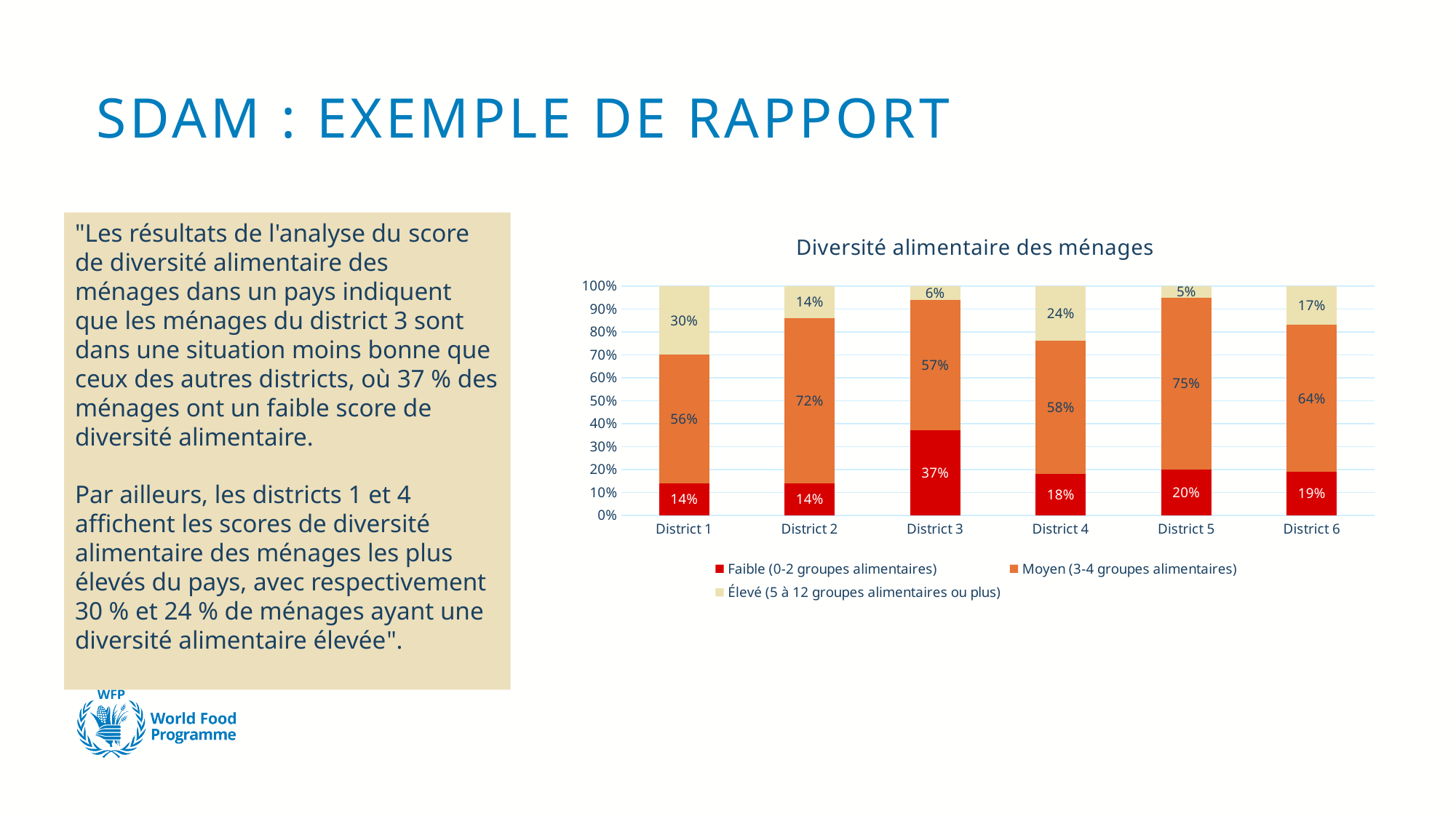
What is the value of the Élevé (5 à 12 groupes alimentaires ou plus) series for District 4? 24% What kind of chart is shown on the slide? Stacked bar chart Which is larger, the Moyen value for District 2 or the Moyen value for District 6? District 2 What is the title of the chart? Diversité alimentaire des ménages Which district has the highest value for the Faible (0-2 groupes alimentaires) series? District 3 Which district has the lowest value for the Élevé (5 à 12 groupes alimentaires ou plus) series? District 5 What is the value of the Faible (0-2 groupes alimentaires) series for District 3? 37% What is the value of the Moyen (3-4 groupes alimentaires) series for District 5? 75% What is the total of the Faible and Moyen segments for District 1? 70% What is the difference between the Élevé values for District 1 and District 2? 16% How many series does the chart legend list? 3 How many districts are shown on the x axis of the chart? 6